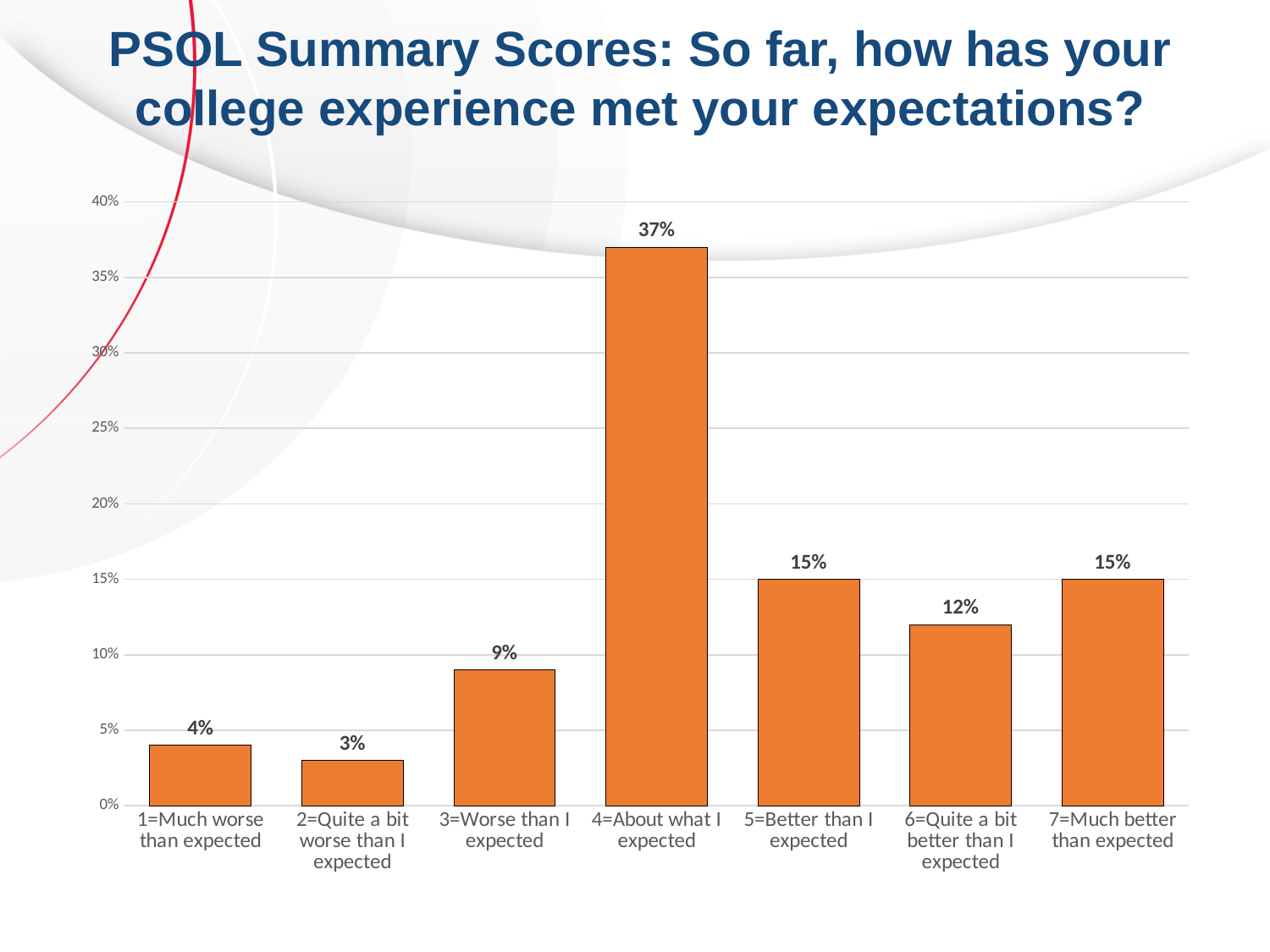
What kind of chart is shown on the slide? Bar chart What is the difference between the values for "4=About what I expected" and "5=Better than I expected"? 22% Which category has the highest value? 4=About what I expected Is the value for "4=About what I expected" greater or less than 35%? greater What colour are the bars in the chart? Orange What is the value for "6=Quite a bit better than I expected"? 12% What percentage of respondents answered "4=About what I expected"? 37% What is the combined value of "1=Much worse than expected" and "2=Quite a bit worse than I expected"? 7% What is the value for "2=Quite a bit worse than I expected"? 3% Which category has the lowest value? 2=Quite a bit worse than I expected How many categories are shown on the x axis? 7 Which is larger, the value for "3=Worse than I expected" or the value for "6=Quite a bit better than I expected"? 6=Quite a bit better than I expected